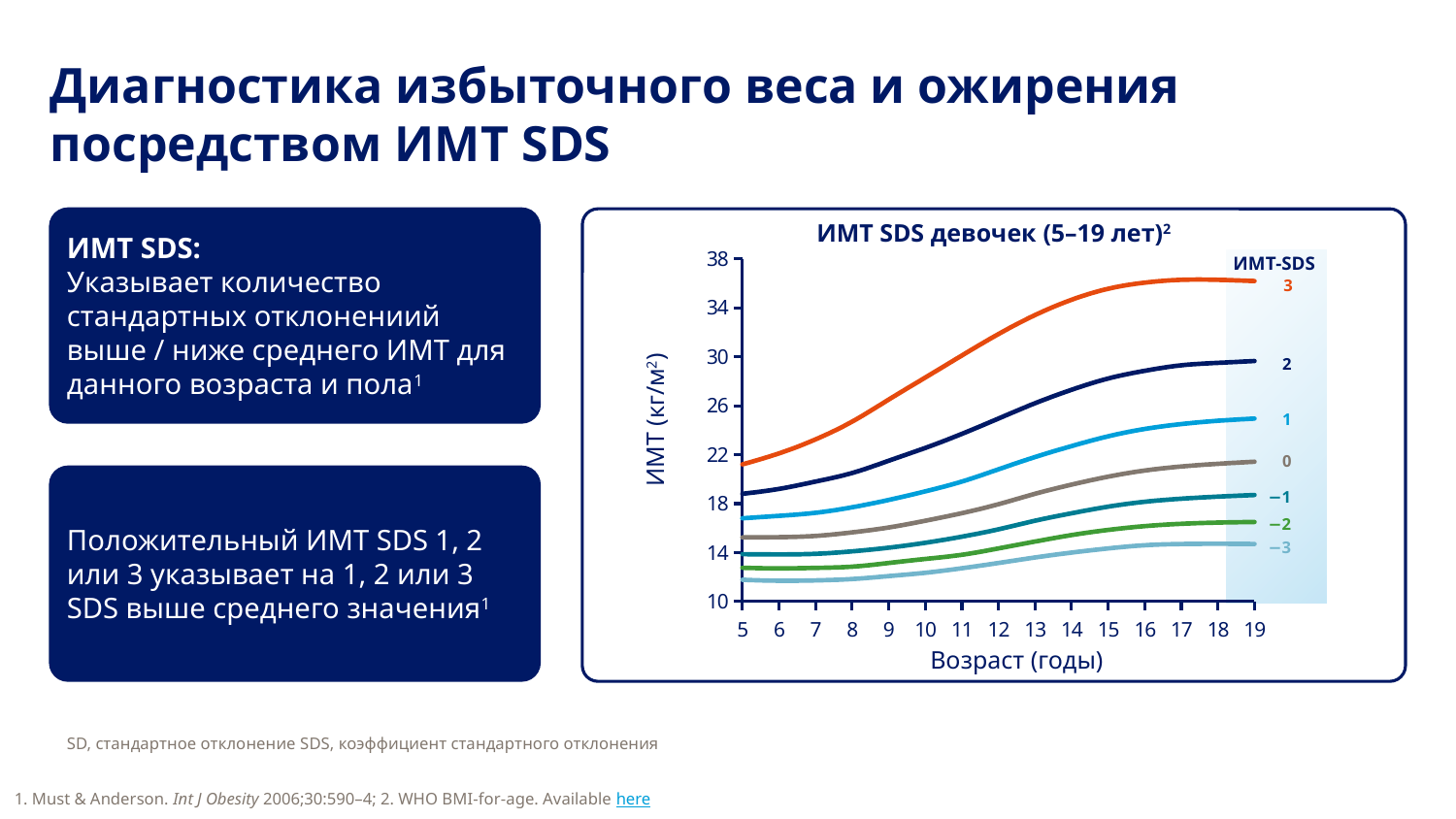
Which ИМТ-SDS curve is the lowest on the chart? −3 How many age values are marked on the x axis of the chart? 15 Which ИМТ-SDS curve is the highest on the chart? 3 What is the title of the chart? ИМТ SDS девочек (5–19 лет) What kind of chart is shown on the slide? line chart How many ИМТ-SDS curves are plotted on the chart? 7 Which curve is higher at age 19, ИМТ-SDS 2 or ИМТ-SDS 0? ИМТ-SDS 2 Is the value of the ИМТ-SDS 3 curve at age 5 greater or less than 18? greater Is the value of the ИМТ-SDS 3 curve at age 19 greater or less than 34? greater What is the label of the x axis of the chart? Возраст (годы) Does the ИМТ-SDS 3 curve rise or fall as age increases from 5 to 19? rise Is the value of the ИМТ-SDS −3 curve at age 5 greater or less than 14? less